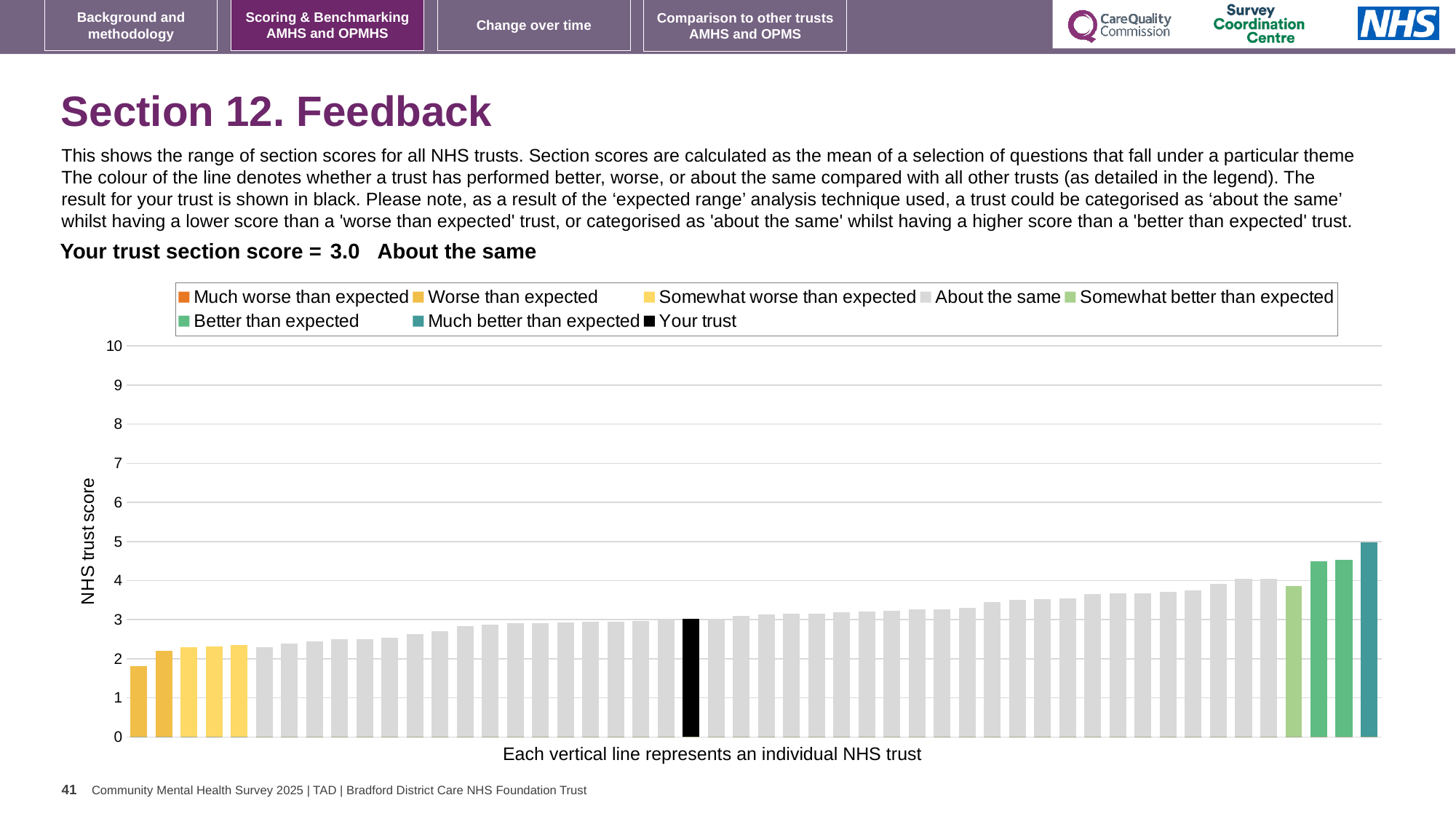
Is the value of the highest bar on the chart greater or less than 4? greater What is the section score for your trust shown on the slide? 3.0 Is the value of the black 'Your trust' bar greater or less than 2? greater How many entries does the chart legend list? 8 How many bars are coloured teal for 'Much better than expected'? 1 What colour is the bar representing your trust? black Which category is your trust placed in for the Feedback section? About the same What is the label on the vertical axis of the chart? NHS trust score What is the highest value shown on the vertical axis? 10 Is the value of the lowest bar on the chart greater or less than 2? less Do the bar values rise or fall from left to right along the x axis? rise What kind of chart is shown on the slide? bar chart